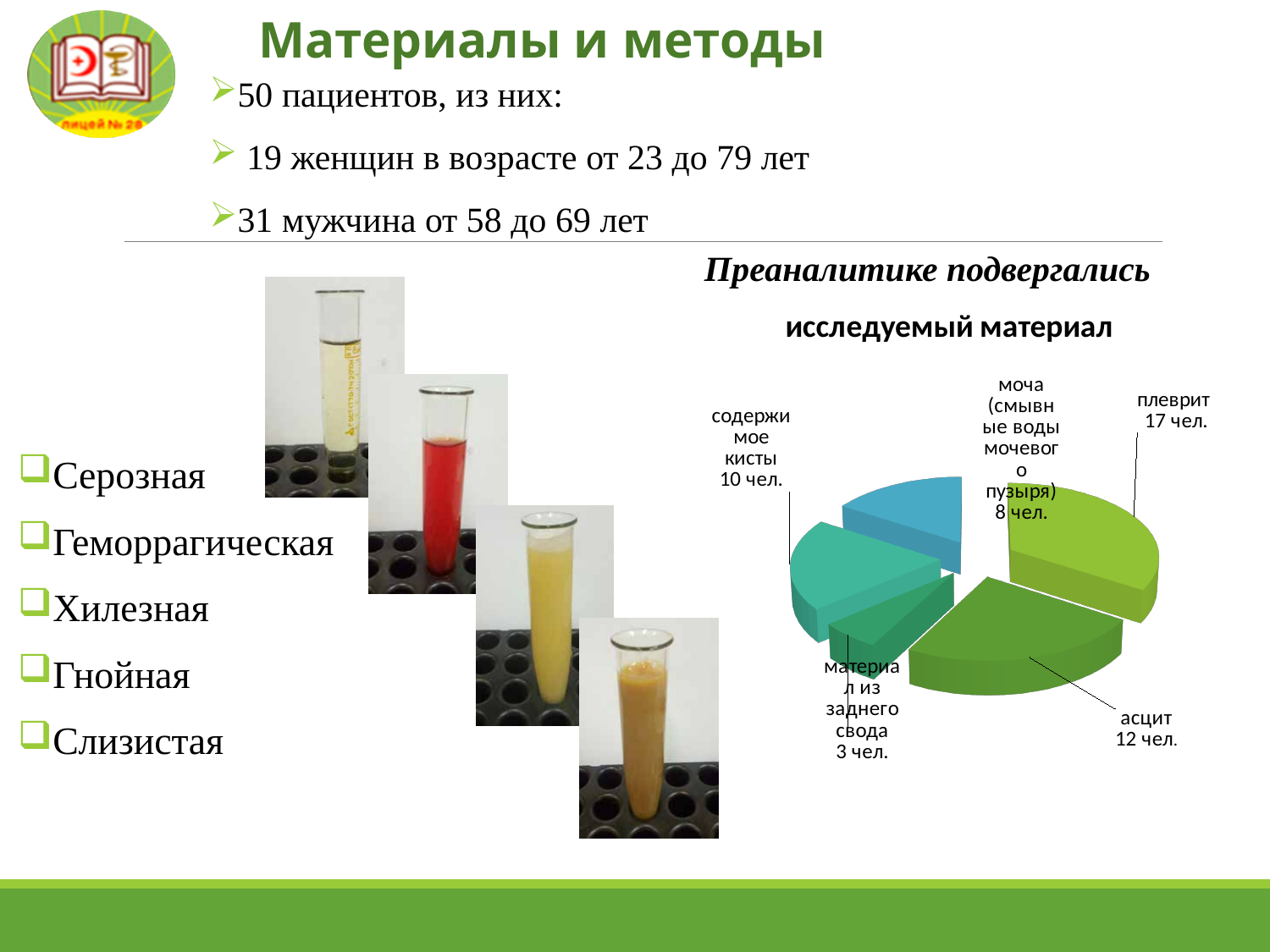
What is the title of the chart? исследуемый материал What is the difference between плеврит and асцит? 5 чел. What is the value for плеврит? 17 чел. What is the value for материал из заднего свода? 3 чел. Which is larger, содержимое кисты or моча (смывные воды мочевого пузыря)? содержимое кисты Which category has the smallest slice? материал из заднего свода What is the value for содержимое кисты? 10 чел. What is the value for моча (смывные воды мочевого пузыря)? 8 чел. Which category has the largest slice? плеврит What is the value for асцит? 12 чел. How many slices does the pie chart have? 5 What type of chart is shown on the slide? pie chart